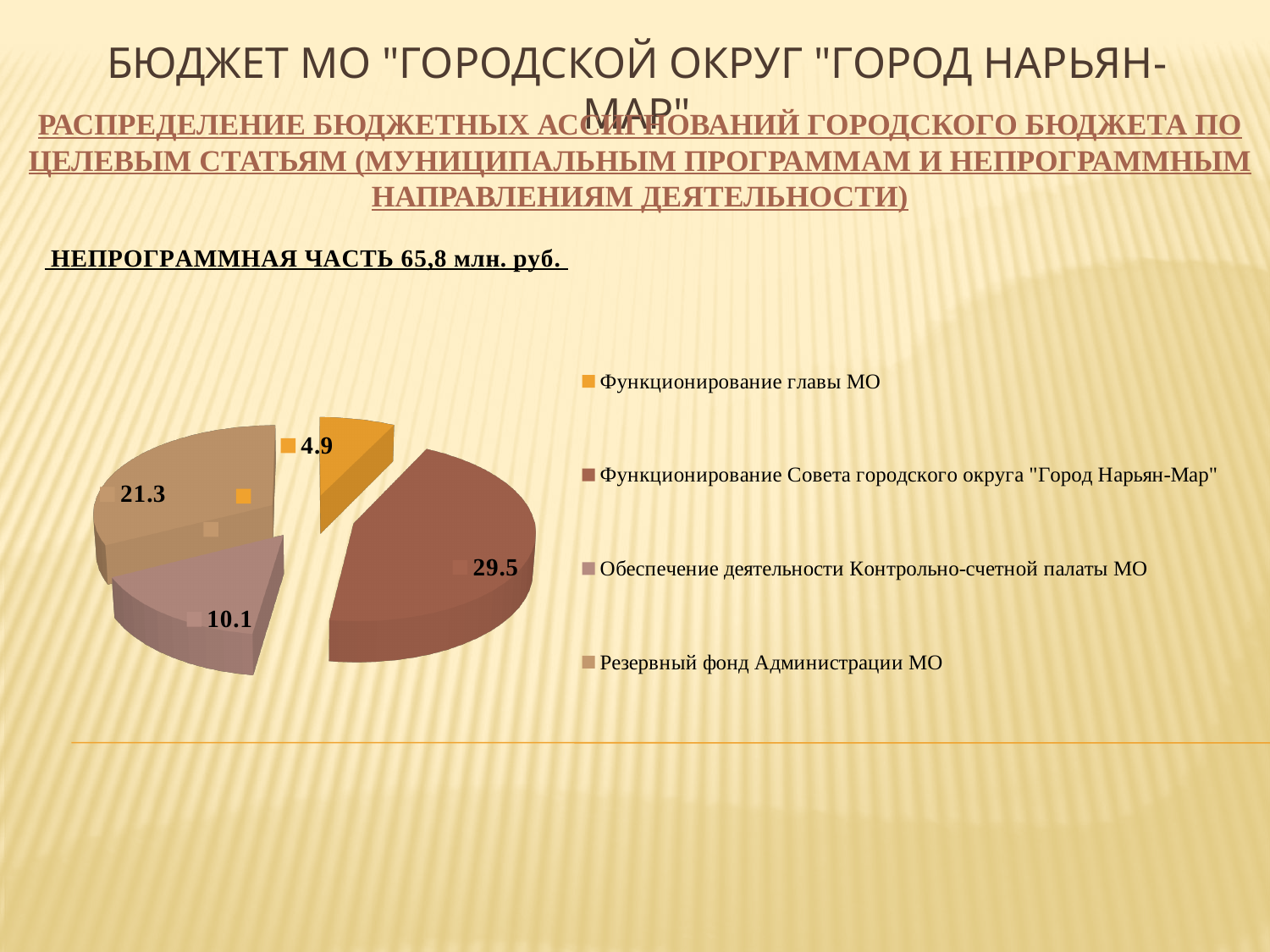
Which category has the smallest slice of the pie? Функционирование главы МО What is the total of all the slice values shown on the pie chart? 65.8 What is the value for "Резервный фонд Администрации МО"? 21.3 What type of chart is shown on the slide? pie chart Which category has the largest slice of the pie? Функционирование Совета городского округа "Город Нарьян-Мар" What is the value for "Функционирование главы МО"? 4.9 How many slices does the pie chart have? 4 What colour is the slice for "Функционирование главы МО"? orange What is the difference between the values for "Функционирование Совета городского округа "Город Нарьян-Мар"" and "Резервный фонд Администрации МО"? 8.2 What is the value for "Обеспечение деятельности Контрольно-счетной палаты МО"? 10.1 What is the value for "Функционирование Совета городского округа "Город Нарьян-Мар""? 29.5 Which is larger: the value for "Резервный фонд Администрации МО" or for "Обеспечение деятельности Контрольно-счетной палаты МО"? Резервный фонд Администрации МО